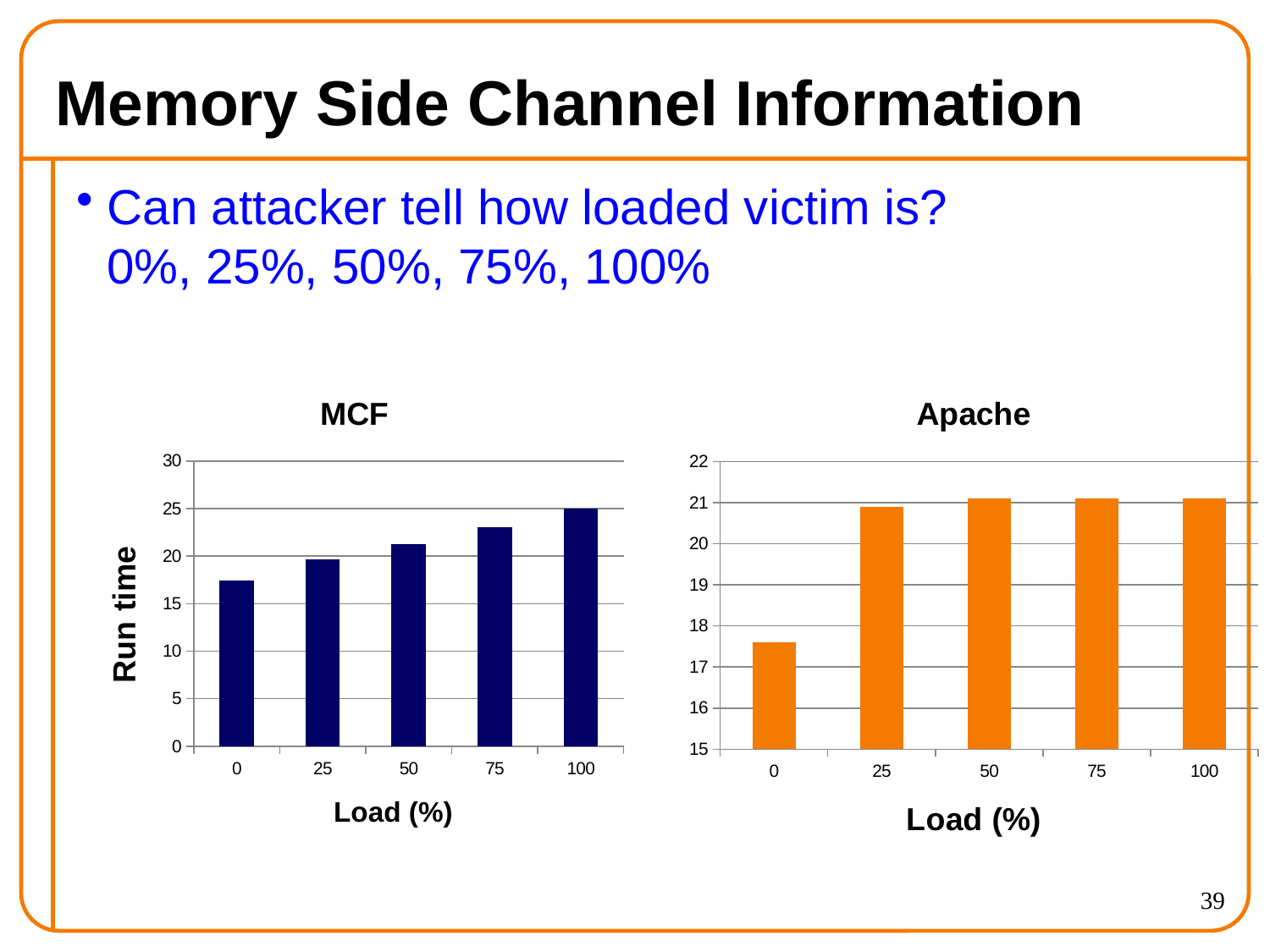
In the Apache chart, which load level has the lowest run time? 0 In the MCF chart, does run time rise or fall as load increases from 0 to 100? rise In the MCF chart, is the run time at 100% load greater or less than 20? greater What is the x-axis label of the Apache chart? Load (%) In the MCF chart, which load level has the lowest run time? 0 In the MCF chart, is the run time at 0% load greater or less than 20? less In the Apache chart, is the run time at 25% load greater or less than 20? greater What type of chart is the MCF chart? bar chart How many bars are shown in the Apache chart? 5 In the MCF chart, which load level has the highest run time? 100 In the MCF chart, which has the higher run time: 25% load or 75% load? 75